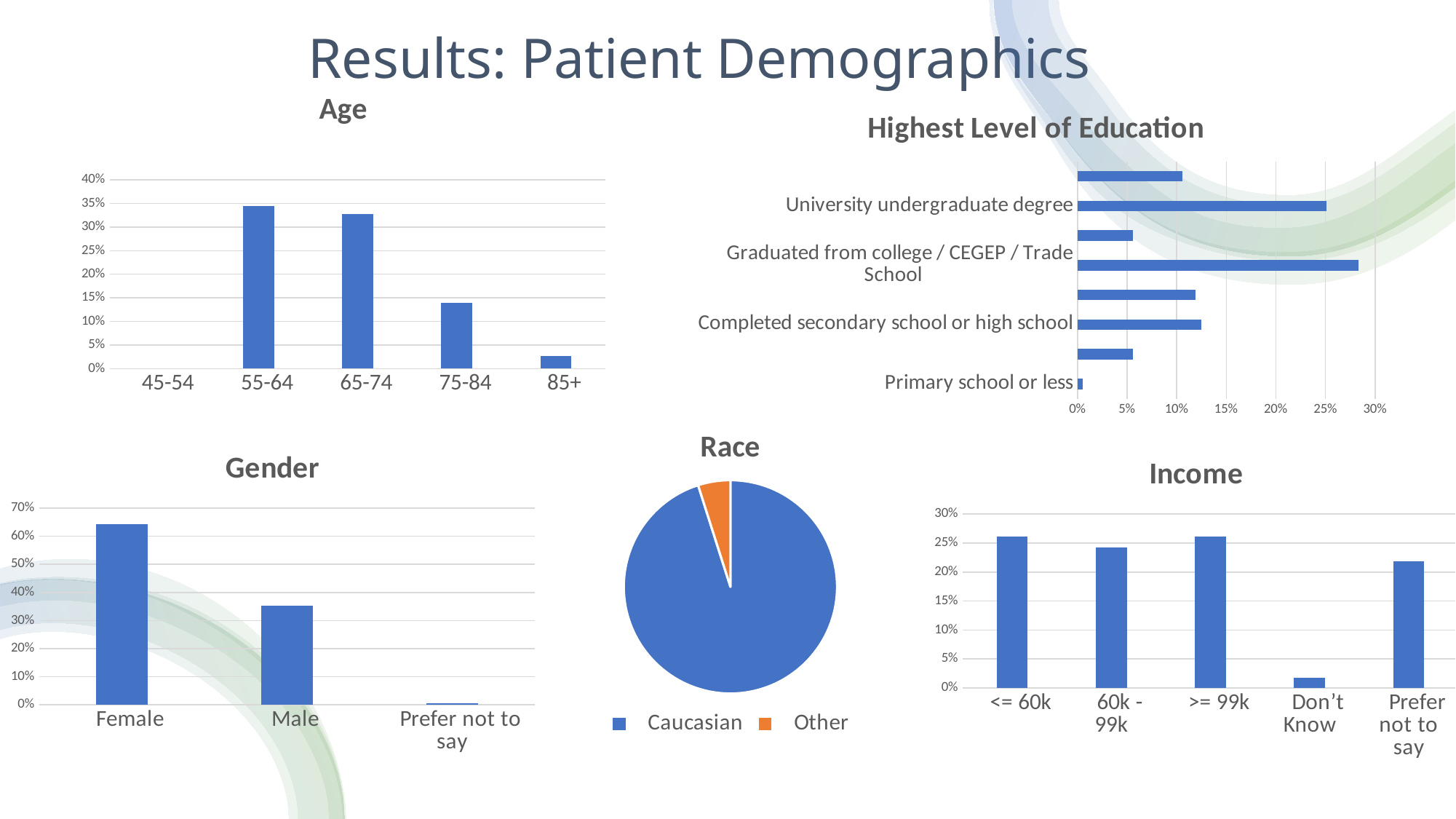
On the Gender chart, is the value for Male greater or less than 40%? less On the Age chart, is the value for 85+ greater or less than 5%? less On the Highest Level of Education chart, is the value for University undergraduate degree greater or less than 20%? greater On the Age chart, how many age categories are shown on the x axis? 5 On the Gender chart, which category has the highest value? Female On the Highest Level of Education chart, which labelled category has the longest bar? Graduated from college / CEGEP / Trade School On the Race chart, how many entries does the legend list? 2 On the Income chart, which category has the lowest value? Don't Know What kind of chart is the Race chart? pie chart